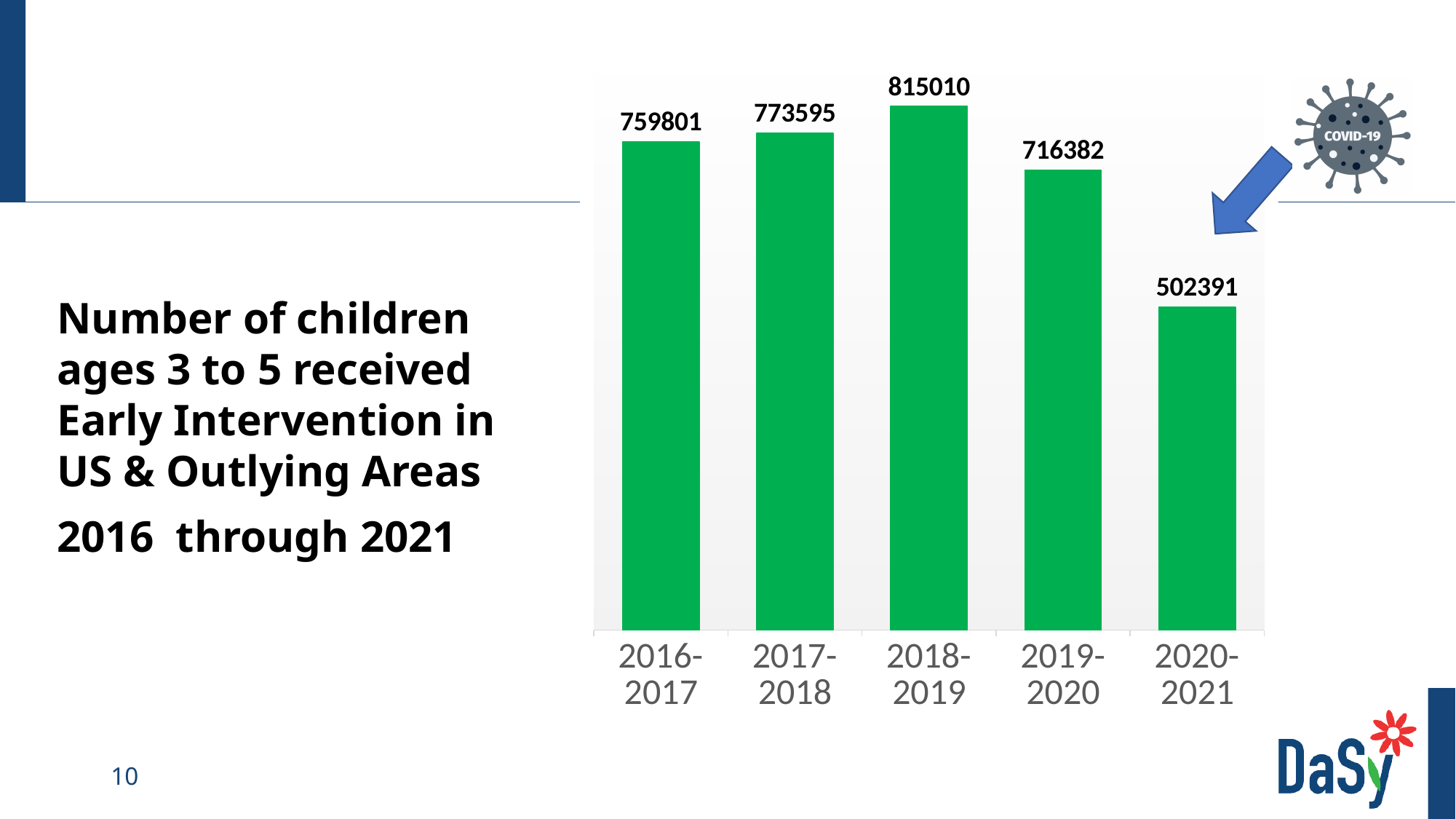
What is the value for 2018-2019? 815010 What is the difference between the values for 2018-2019 and 2020-2021? 312619 Which is larger, the value for 2017-2018 or the value for 2019-2020? 2017-2018 Which school year has the lowest value? 2020-2021 How many school years are shown on the x axis? 5 Do the values rise or fall from 2018-2019 to 2020-2021? Fall What kind of chart is shown on the slide? Bar chart What is the difference between the values for 2017-2018 and 2016-2017? 13794 What is the value for 2019-2020? 716382 What is the value for 2020-2021? 502391 Which school year has the highest value? 2018-2019 What is the value for 2016-2017? 759801